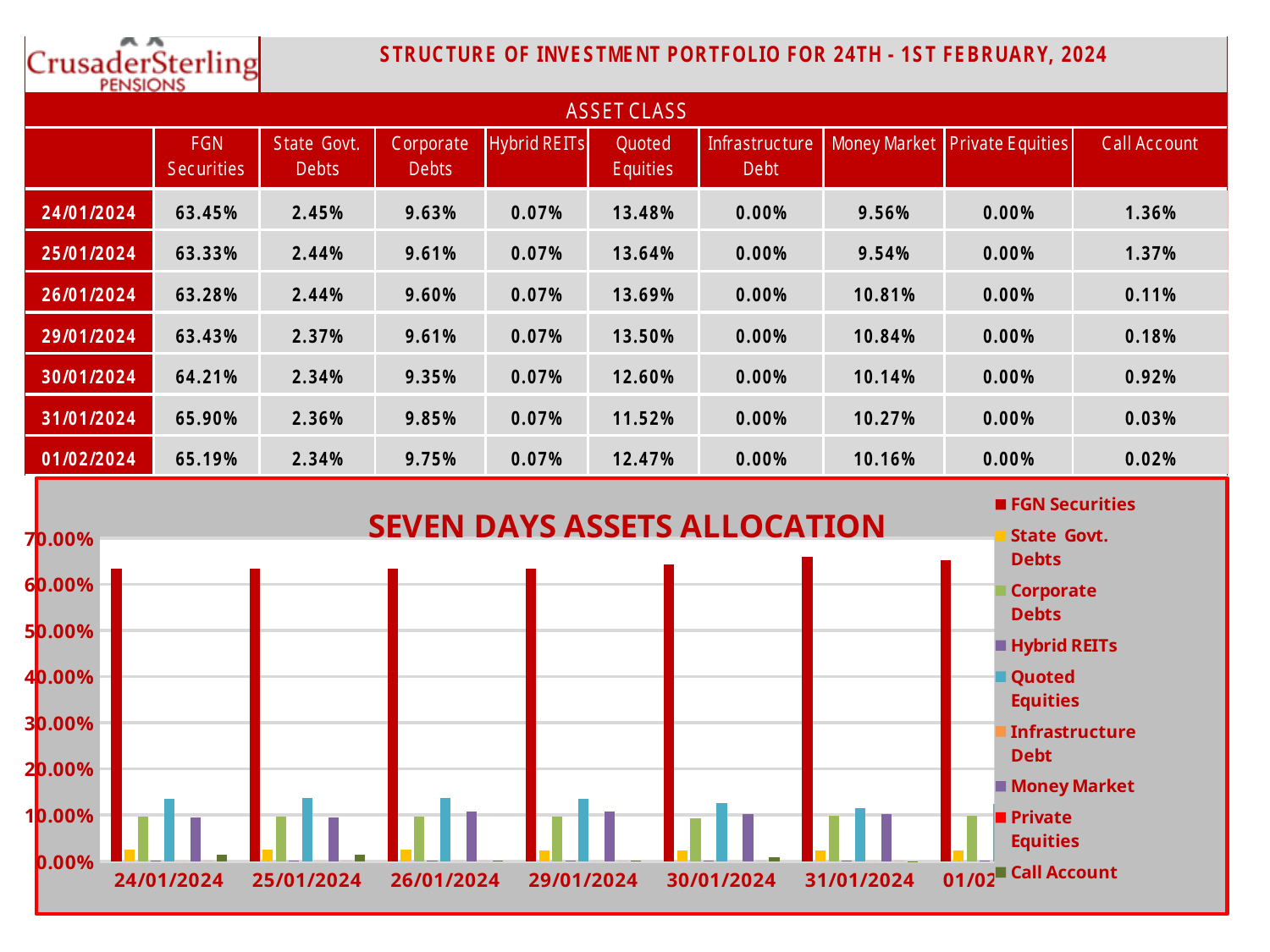
Is the value for Quoted Equities on 25/01/2024 greater or less than 20.00%? less What is the Money Market allocation on 29/01/2024? 10.84% How many dates are plotted along the x axis of the chart? 7 What is the difference between the Quoted Equities allocation on 26/01/2024 and on 31/01/2024? 2.17% On 24/01/2024, which is larger: Quoted Equities or Money Market? Quoted Equities What is the FGN Securities allocation on 31/01/2024? 65.90% Is the value for FGN Securities on 24/01/2024 greater or less than 60.00%? greater What kind of chart is shown on the slide? Bar chart On which date is the FGN Securities allocation lowest? 26/01/2024 What is the title of the chart? SEVEN DAYS ASSETS ALLOCATION How many series does the chart legend list? 9 On which date is the FGN Securities allocation highest? 31/01/2024